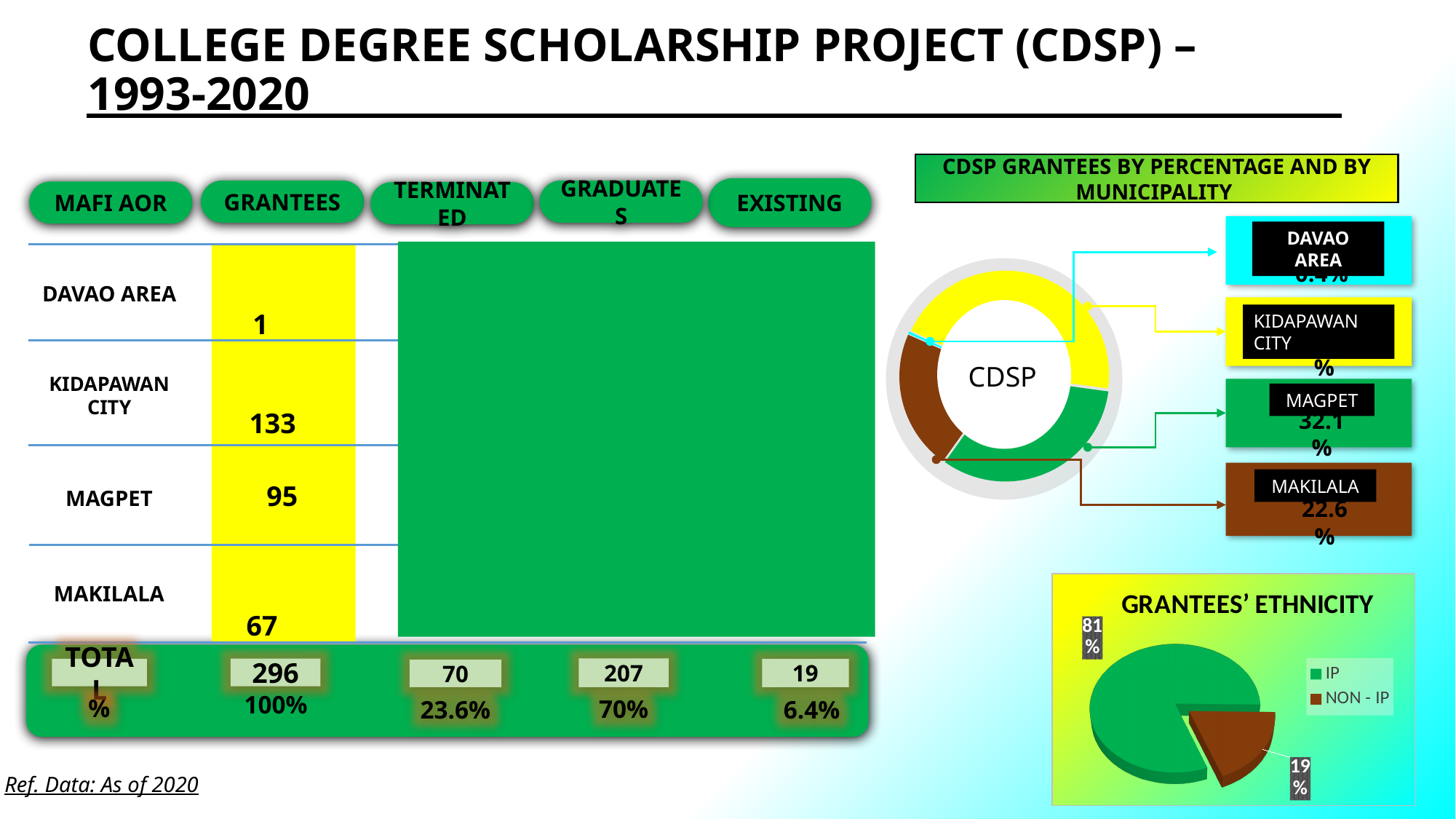
In the CDSP GRANTEES BY PERCENTAGE AND BY MUNICIPALITY chart, which has the larger share, MAGPET or MAKILALA? MAGPET How many slices does the GRANTEES' ETHNICITY pie chart have? 2 In the CDSP GRANTEES BY PERCENTAGE AND BY MUNICIPALITY chart, what is the percentage for MAKILALA? 22.6% How many entries does the legend of the GRANTEES' ETHNICITY chart list? 2 In the CDSP GRANTEES BY PERCENTAGE AND BY MUNICIPALITY chart, what is the percentage for MAGPET? 32.1% What kind of chart is the GRANTEES' ETHNICITY chart? Pie chart In the GRANTEES' ETHNICITY chart, what percentage of grantees are IP? 81% How many municipalities are labelled in the CDSP GRANTEES BY PERCENTAGE AND BY MUNICIPALITY chart? 4 In the GRANTEES' ETHNICITY chart, what percentage of grantees are NON - IP? 19% In the CDSP GRANTEES BY PERCENTAGE AND BY MUNICIPALITY chart, what is the difference between the MAGPET and MAKILALA percentages? 9.5% In the GRANTEES' ETHNICITY chart, what is the difference between the IP share and the NON - IP share? 62% In the GRANTEES' ETHNICITY chart, which group has the larger share, IP or NON - IP? IP